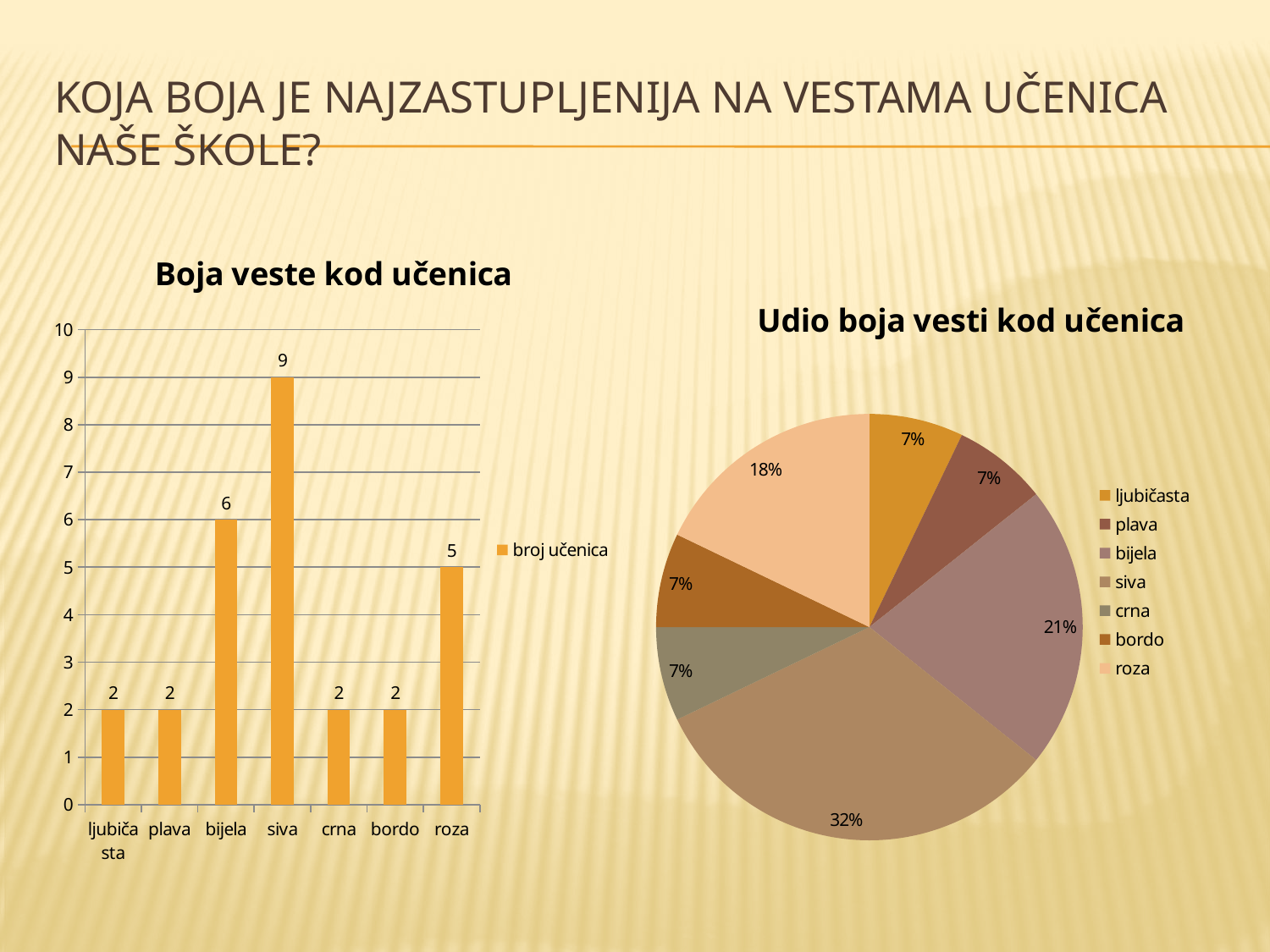
In the pie chart 'Udio boja vesti kod učenica', what share does roza have? 18% In the bar chart 'Boja veste kod učenica', what is the value for siva? 9 In the bar chart 'Boja veste kod učenica', what is the difference between the values for siva and bijela? 3 In the bar chart 'Boja veste kod učenica', which is larger, the value for bijela or the value for roza? bijela In the bar chart 'Boja veste kod učenica', what is the value for roza? 5 In the bar chart 'Boja veste kod učenica', which category has the highest value? siva In the bar chart 'Boja veste kod učenica', how many categories are shown on the x axis? 7 In the pie chart 'Udio boja vesti kod učenica', what share does siva have? 32% In the bar chart 'Boja veste kod učenica', what is the total of all the bar values? 28 In the pie chart 'Udio boja vesti kod učenica', how many entries does the legend list? 7 What kind of chart is 'Boja veste kod učenica'? bar chart What is the legend entry of the bar chart on the left? broj učenica